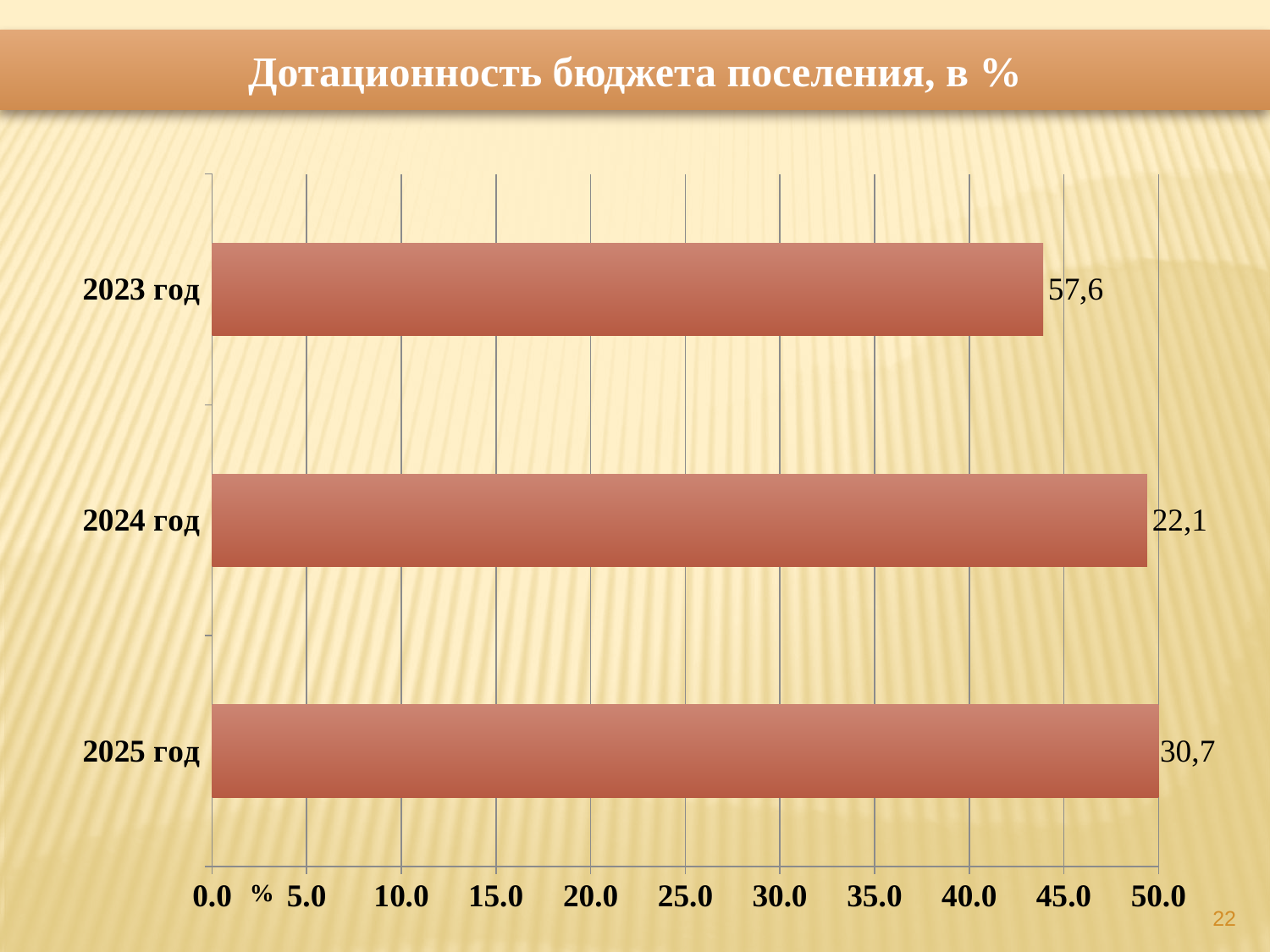
What is the difference between the labelled values for 2023 год and 2024 год? 35,5 What kind of chart is shown on the slide? Bar chart What is the value shown for 2025 год? 30,7 What is the value shown for 2023 год? 57,6 What is the highest value printed on the horizontal axis? 50.0 What is the title of the slide? Дотационность бюджета поселения, в % What is the value shown for 2024 год? 22,1 How many categories (years) are shown in the chart? 3 What is the difference between the labelled values for 2023 год and 2025 год? 26,9 What is the difference between the labelled values for 2025 год and 2024 год? 8,6